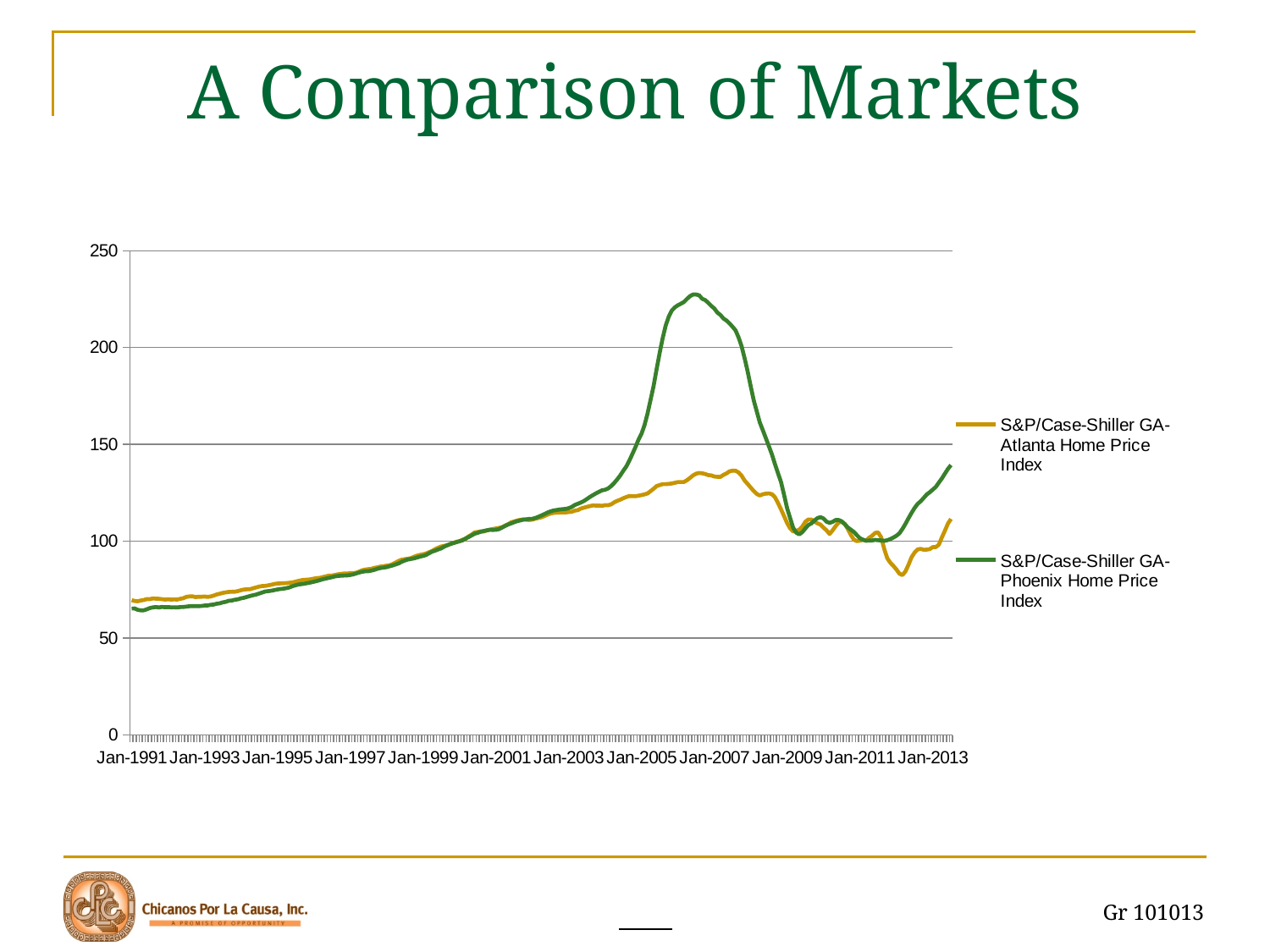
Is the peak value of the Phoenix Home Price Index greater or less than 200? greater How many series does the legend list? 2 Which series reaches the higher peak value, Atlanta or Phoenix? S&P/Case-Shiller GA-Phoenix Home Price Index What colour is the line for the S&P/Case-Shiller GA-Phoenix Home Price Index? green Is the value for the Phoenix Home Price Index at Jan-2013 greater or less than 150? less What is the title of the slide containing the chart? A Comparison of Markets Is the value for the Atlanta Home Price Index at Jan-1991 greater or less than 50? greater What kind of chart is shown on the slide? line chart Does the Phoenix Home Price Index rise or fall between Jan-2003 and Jan-2006? rise Does the Phoenix Home Price Index rise or fall between Jan-2007 and Jan-2009? fall